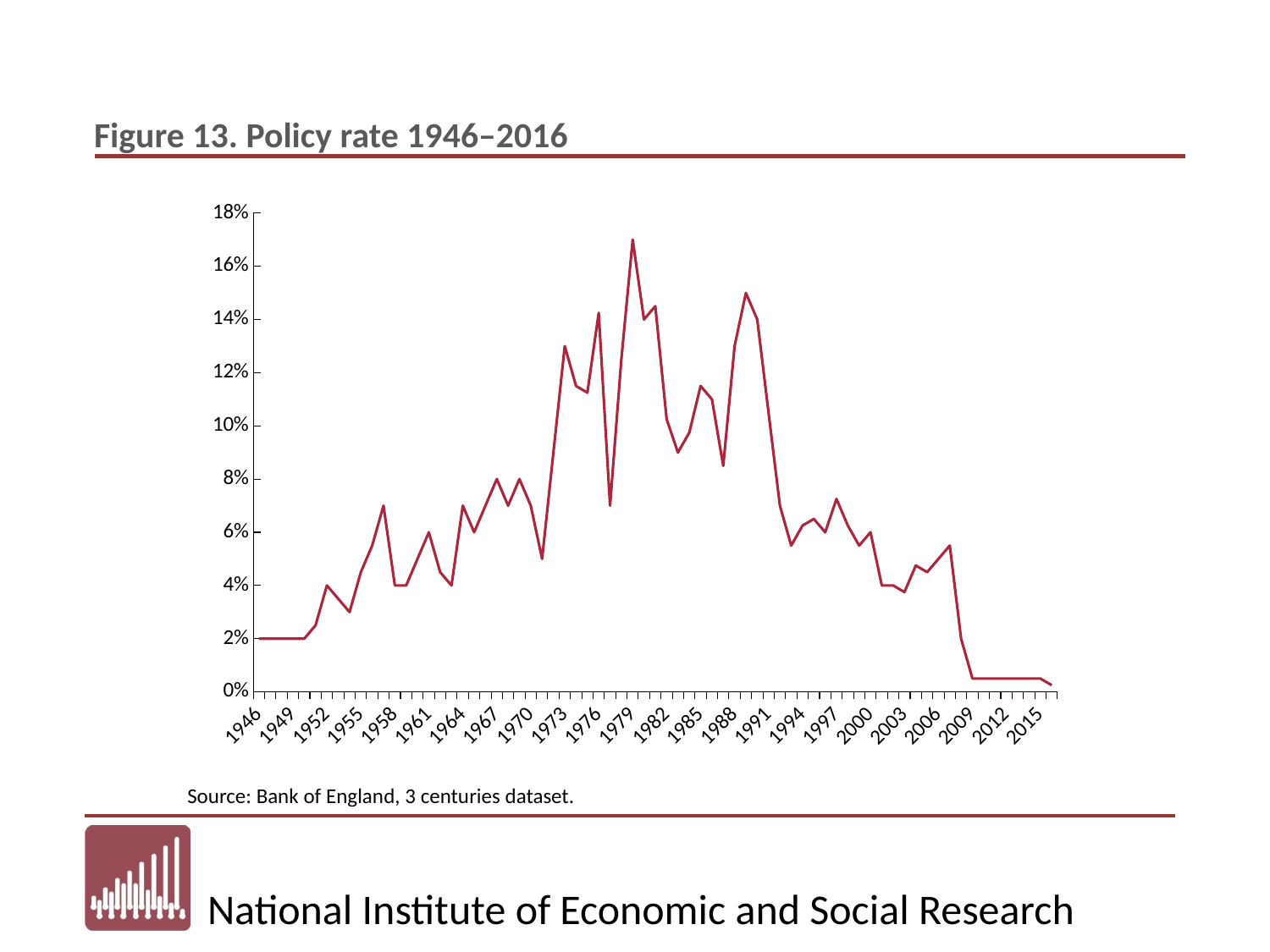
Which year has the higher policy rate, 1979 or 1989? 1979 Does the policy rate rise or fall between 1989 and 2009? Fall Is the policy rate in 1989 greater or less than 14%? greater Is the policy rate in 1957 greater or less than 6%? greater Which year has the higher policy rate, 1946 or 2015? 1946 Is the policy rate in 2009 greater or less than 2%? less What is the highest value shown on the vertical axis? 18% What is the title of the chart? Figure 13. Policy rate 1946–2016 In which year does the policy rate reach its highest value? 1979 What kind of chart is shown on the slide? Line chart What is the policy rate shown for 1946? 2%